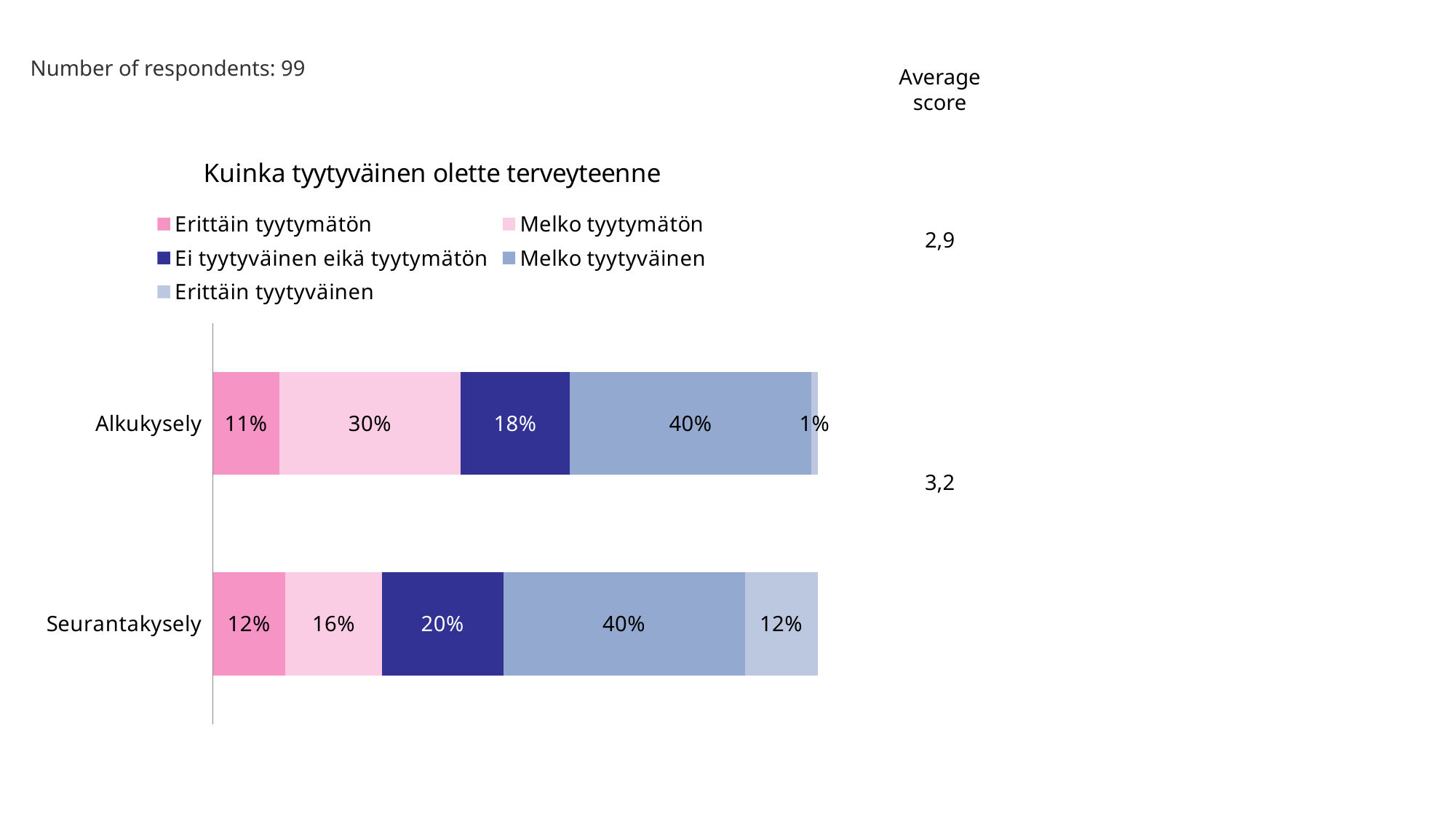
What is the value for Melko tyytymätön in the Alkukysely bar? 30% Which is larger: Erittäin tyytymätön for Alkukysely or for Seurantakysely? Seurantakysely What kind of chart is shown on the slide? Stacked bar chart What is the difference between the Melko tyytymätön values for Alkukysely and Seurantakysely? 14 percentage points What is the value for Erittäin tyytyväinen in the Alkukysely bar? 1% Which segment is the largest in the Alkukysely bar? Melko tyytyväinen What is the value for Ei tyytyväinen eikä tyytymätön in the Seurantakysely bar? 20% How many categories (bars) are shown in the chart? 2 Which segment is the smallest in the Seurantakysely bar? Erittäin tyytymätön and Erittäin tyytyväinen (tied at 12%) What is the value for Erittäin tyytyväinen in the Seurantakysely bar? 12% What is the title of the chart? Kuinka tyytyväinen olette terveyteenne How many series does the legend list? 5